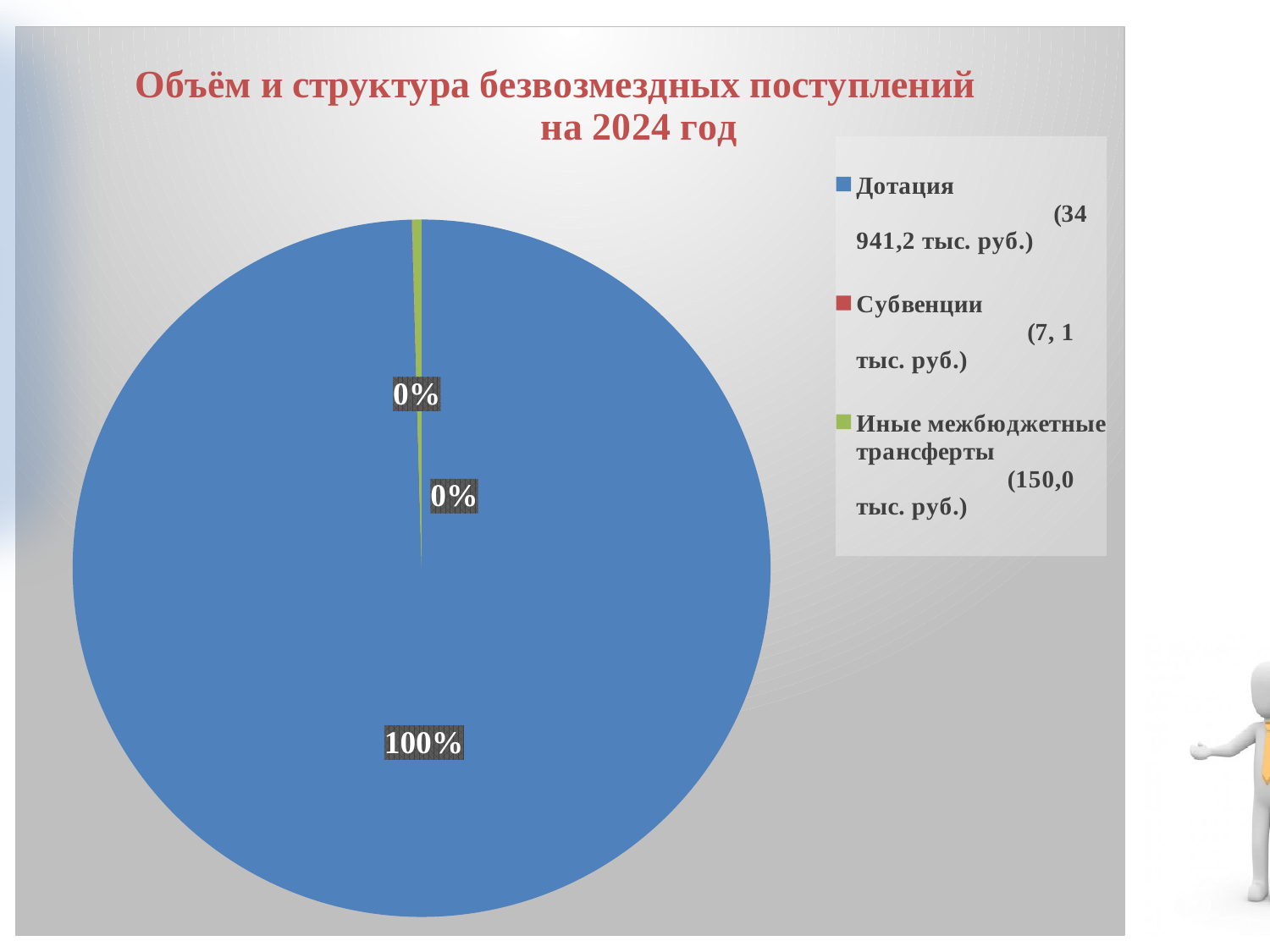
What amount is given in the legend for Дотация? 34 941,2 тыс. руб. What kind of chart is shown on the slide? pie chart How many entries does the legend list? 3 What colour is the slice for Дотация? blue What is the title of the chart? Объём и структура безвозмездных поступлений на 2024 год Which category has the smallest amount according to the legend? Субвенции What share of the pie is labelled for Дотация? 100% Which category has the largest share of the pie? Дотация Which is larger according to the legend: Иные межбюджетные трансферты or Субвенции? Иные межбюджетные трансферты What amount is given in the legend for Субвенции? 7, 1 тыс. руб. How many slices (categories) does the pie chart have? 3 What amount is given in the legend for Иные межбюджетные трансферты? 150,0 тыс. руб.